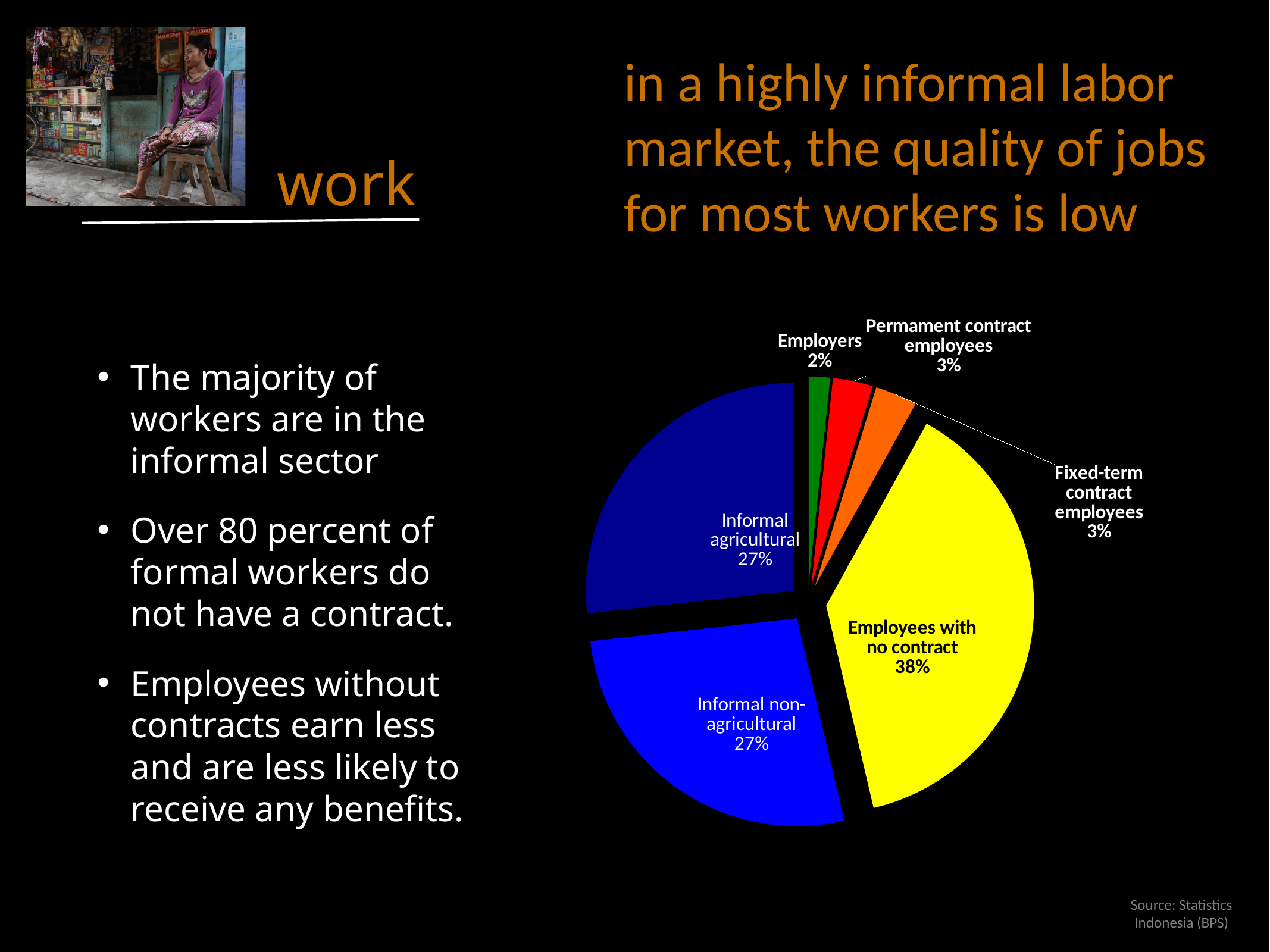
Which category has the smallest slice of the pie? Employers What is the value for Employers? 2% What is the value for Informal agricultural? 27% How many categories are shown in the pie chart? 6 What colour is the Employees with no contract slice? Yellow What is the combined share of Informal agricultural and Informal non-agricultural? 54% What share of the pie is Employees with no contract? 38% Which is larger, Employees with no contract or Informal non-agricultural? Employees with no contract Which category has the largest slice of the pie? Employees with no contract What kind of chart is shown on the slide? Pie chart What is the difference between Employees with no contract and Informal agricultural? 11 percentage points What is the value for Fixed-term contract employees? 3%